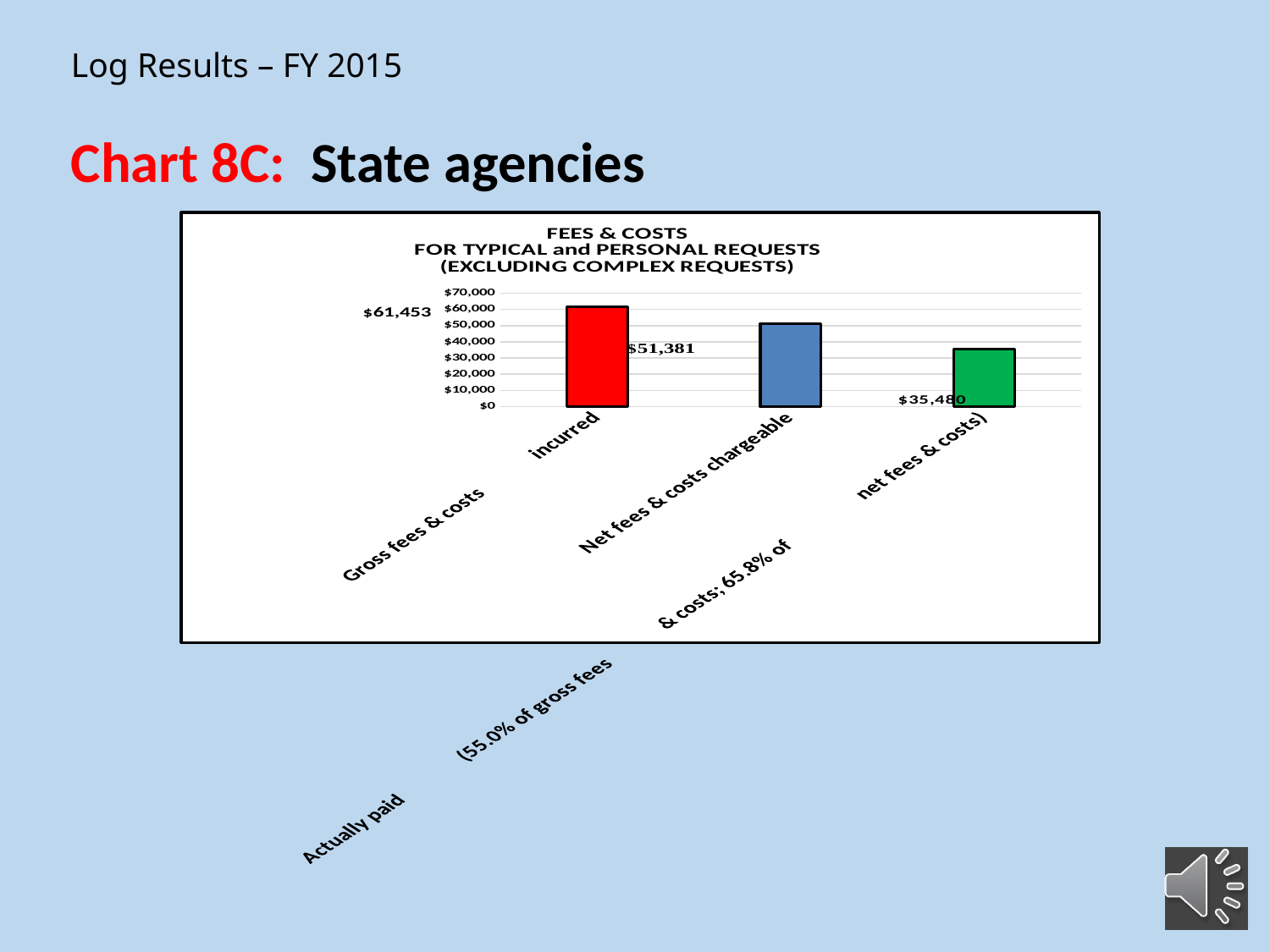
Which is larger, Net fees & costs chargeable or Actually paid? Net fees & costs chargeable What colour is the bar for Gross fees & costs incurred? Red How many bars are plotted in the chart? 3 Which category has the highest value? Gross fees & costs incurred What is the difference between Net fees & costs chargeable and Actually paid? $15,901 Which category has the lowest value? Actually paid Is the value for Actually paid greater or less than $40,000? less What is the value for Net fees & costs chargeable? $51,381 What type of chart is shown on the slide? Bar chart What is the value for Gross fees & costs incurred? $61,453 What is the difference between Gross fees & costs incurred and Net fees & costs chargeable? $10,072 What is the value for Actually paid? $35,480